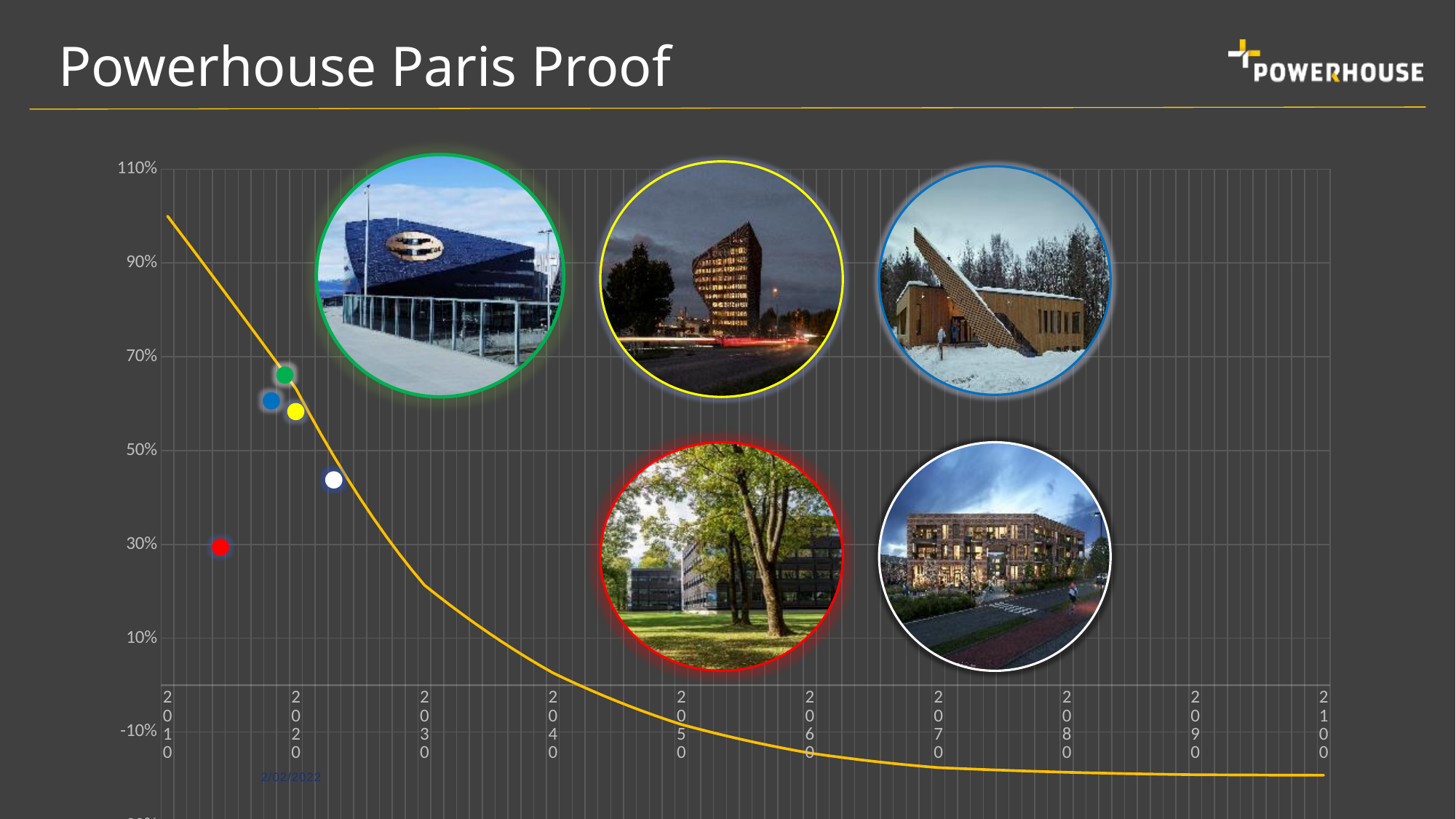
Which coloured dot has the lowest value on the chart? red Which is higher on the chart, the green dot or the red dot? green dot How many coloured dots are plotted on the chart? 5 Is the value of the green dot greater or less than 50%? greater What kind of chart is shown on the slide? line chart Does the orange line rise or fall as the years increase along the x axis? fall What is the first year and the last year shown on the x axis? 2010 and 2100 Is the value of the orange line at 2050 greater or less than 10%? less Which coloured dot has the highest value on the chart? green Is the value of the red dot greater or less than 50%? less What is the title of the slide containing the chart? Powerhouse Paris Proof